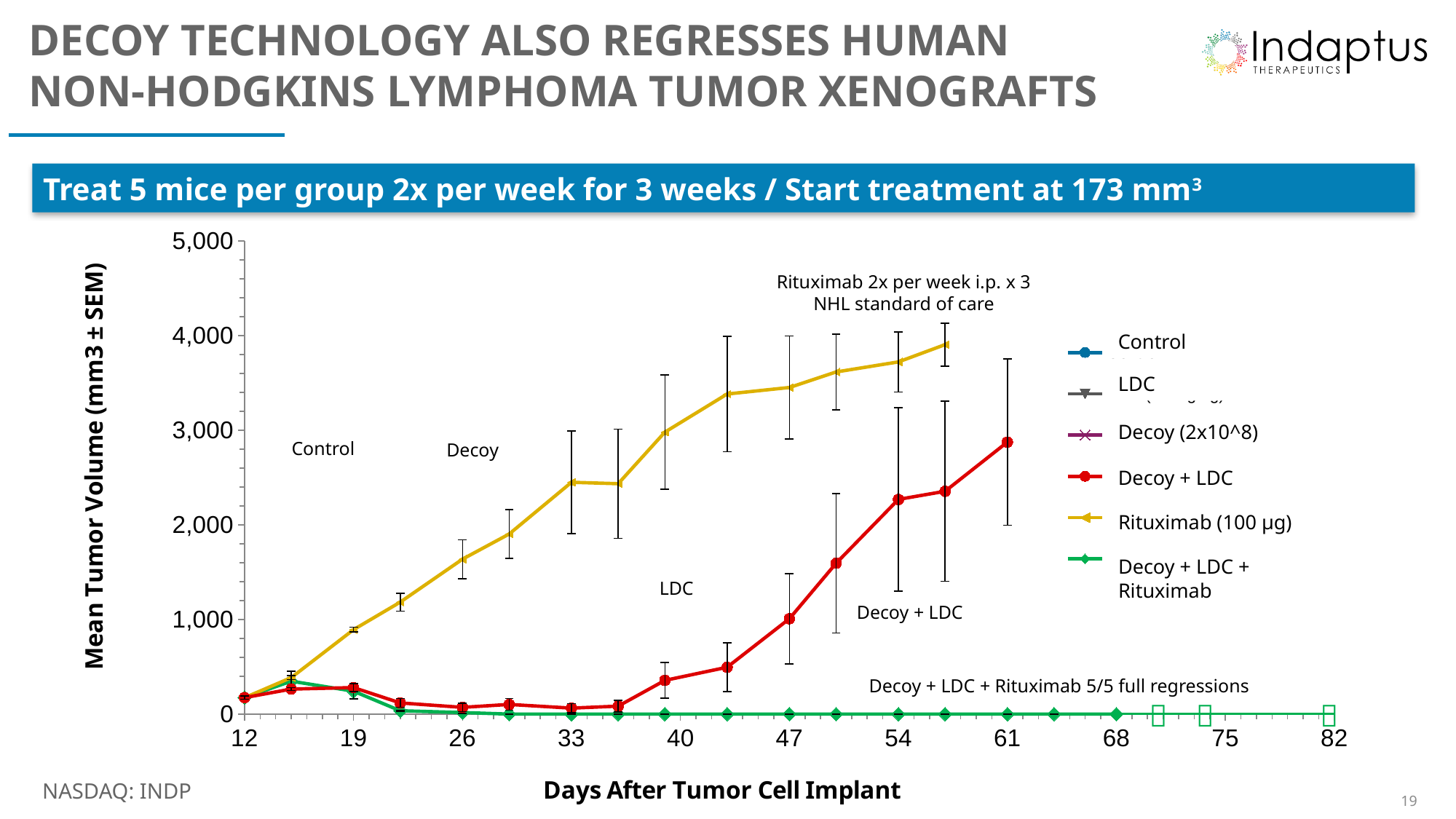
Is the value for Rituximab (100 µg) at day 54 greater or less than 3,000? greater What kind of chart is shown on the slide? Line chart Is the value for Decoy + LDC at day 61 greater or less than 2,000? greater At day 61, which series has the larger mean tumor volume: Decoy + LDC or Decoy + LDC + Rituximab? Decoy + LDC Does the Decoy + LDC series rise or fall between day 40 and day 61? Rise How many tick labels are shown on the x axis (Days After Tumor Cell Implant)? 11 At day 47, which series has the larger mean tumor volume: Rituximab (100 µg) or Decoy + LDC? Rituximab (100 µg) How many series does the legend list? 6 According to the annotation on the chart, how many full regressions were seen in the Decoy + LDC + Rituximab group? 5/5 What is the label of the y axis? Mean Tumor Volume (mm3 ± SEM) Is the value for Decoy + LDC + Rituximab at day 82 greater or less than 1,000? less Which series reaches the highest mean tumor volume on the chart? Rituximab (100 µg)